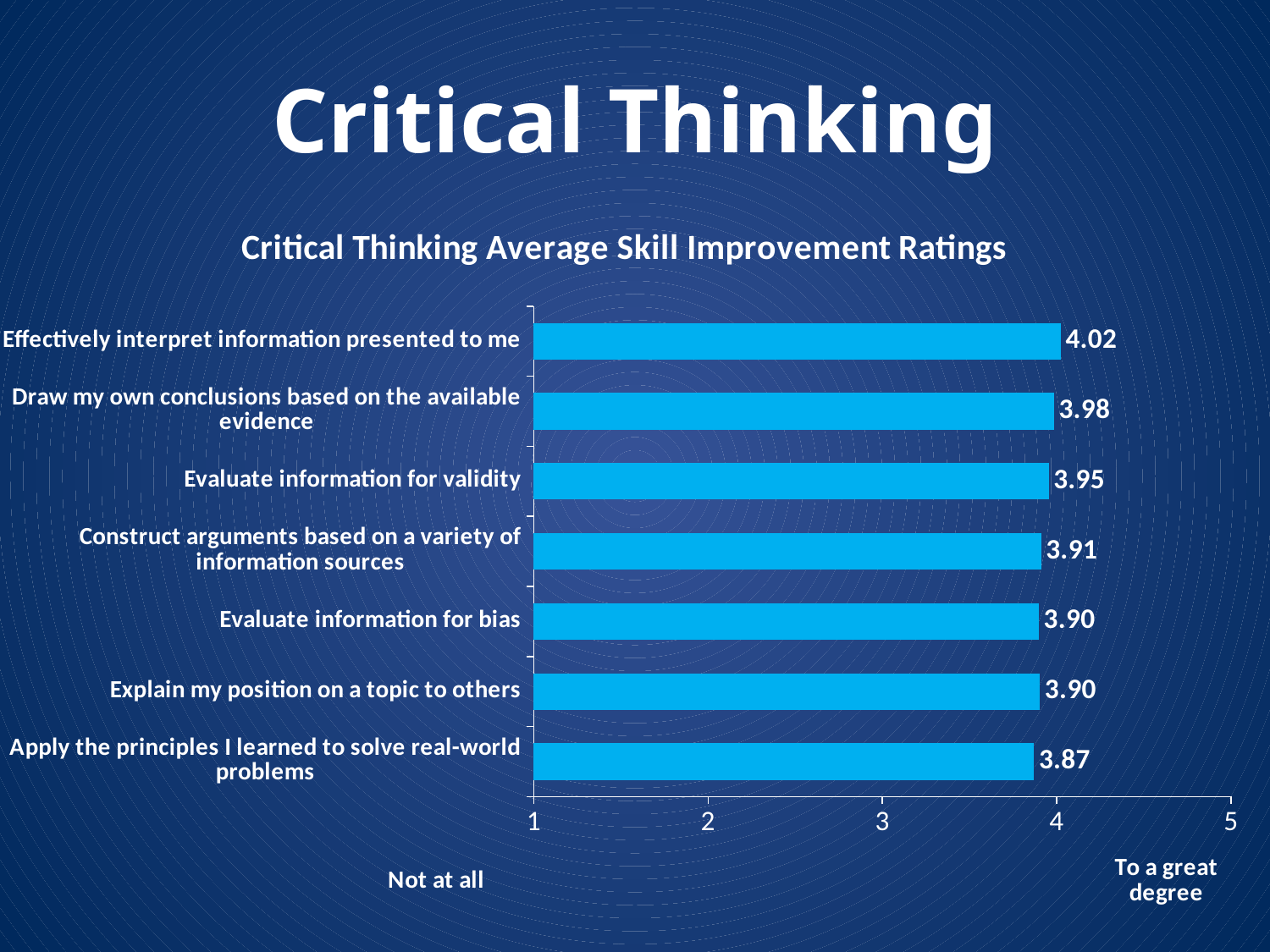
What is the title of the chart? Critical Thinking Average Skill Improvement Ratings What is the difference between the ratings for 'Effectively interpret information presented to me' and 'Apply the principles I learned to solve real-world problems'? 0.15 Which has a higher rating: 'Draw my own conclusions based on the available evidence' or 'Construct arguments based on a variety of information sources'? Draw my own conclusions based on the available evidence What is the rating for 'Evaluate information for validity'? 3.95 What label appears at the right end of the x axis, under the value 5? To a great degree What kind of chart is shown on the slide? Bar chart What is the average skill improvement rating for 'Effectively interpret information presented to me'? 4.02 Which category has the lowest average skill improvement rating? Apply the principles I learned to solve real-world problems How many categories are shown in the chart? 7 What is the rating for 'Apply the principles I learned to solve real-world problems'? 3.87 Which category has the highest average skill improvement rating? Effectively interpret information presented to me Is the rating for 'Evaluate information for bias' greater or less than 4? less